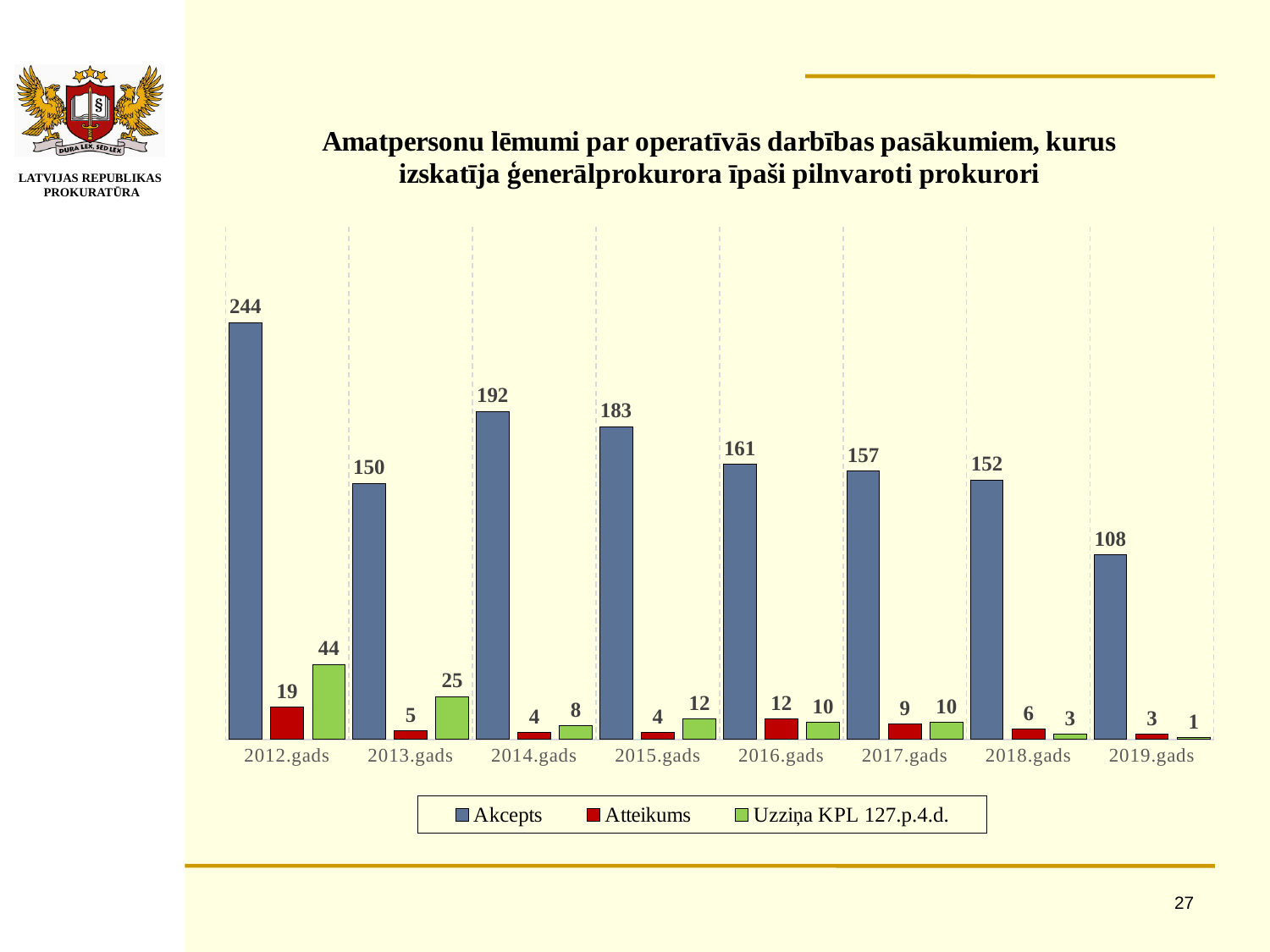
What is the Akcepts value for 2012.gads? 244 How many series does the legend list? 3 Which year has the lowest Akcepts value? 2019.gads Which series is shown in red in the legend? Atteikums Which is larger, the Atteikums value for 2012.gads or the Atteikums value for 2017.gads? 2012.gads How many years are shown on the x axis? 8 What is the difference between the Akcepts values for 2014.gads and 2015.gads? 9 Which year has the highest Akcepts value? 2012.gads What is the total of the three series for 2019.gads? 112 What is the Uzziņa KPL 127.p.4.d. value for 2013.gads? 25 What is the Atteikums value for 2016.gads? 12 What kind of chart is shown on the slide? bar chart